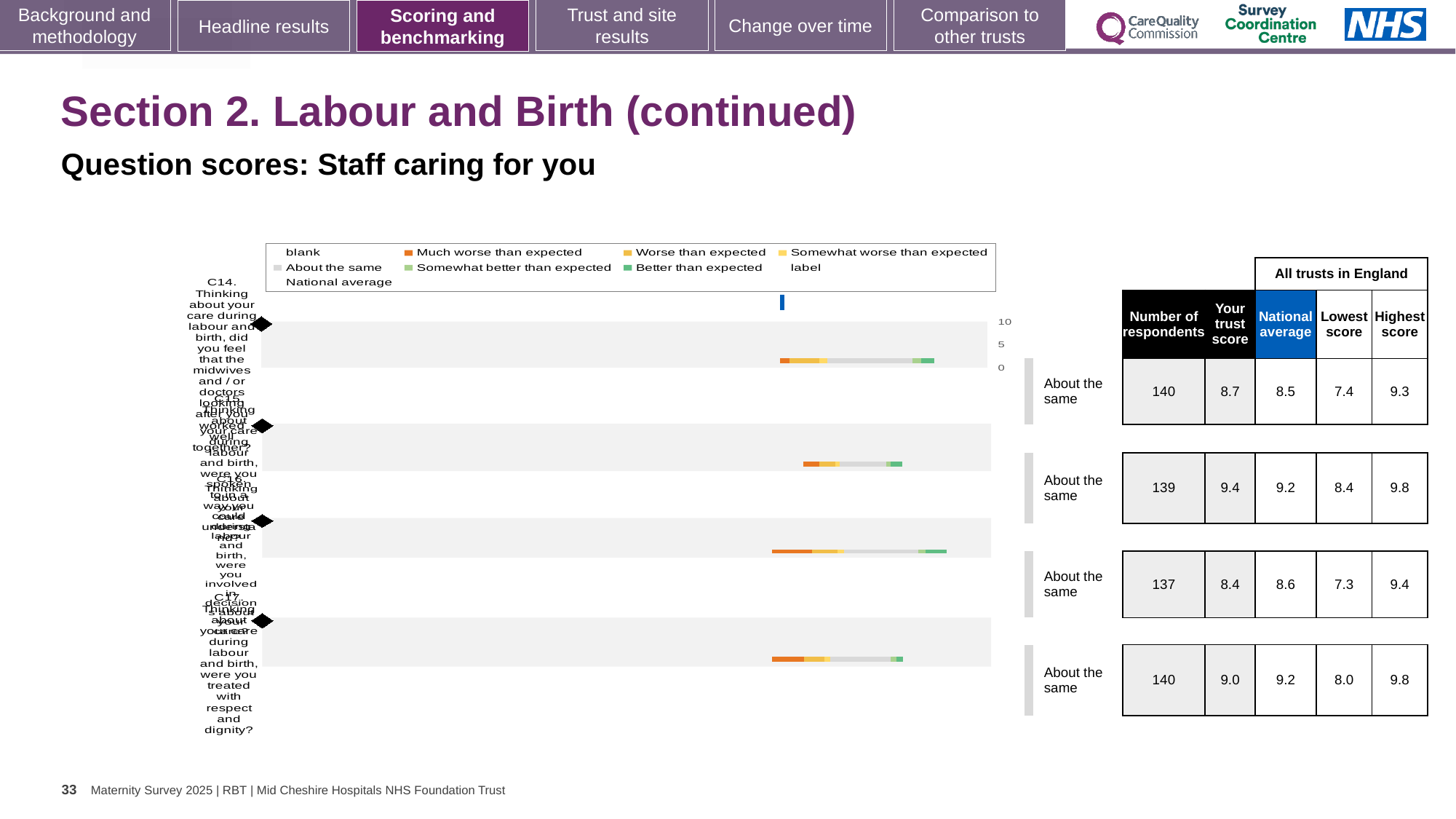
For the third row (C16), is the trust score or the national average larger? national average (8.6) What kind of chart is shown on the slide? bar chart What is the national average for the second row (C15) in the table beside the chart? 9.2 How many entries does the chart legend list? 9 What is the highest score across all trusts in England for the fourth row (C17)? 9.8 What is the difference between the trust score and the national average for the first row (C14)? 0.2 What is the number of respondents for the third row (C16)? 137 Which row has the lowest 'Your trust score' in the table? third row (C16), 8.4 What benchmark category label is shown next to each of the four bars? About the same Which row has the highest 'Your trust score' in the table? second row (C15), 9.4 What is the 'Your trust score' for the first row (C14) in the table beside the chart? 8.7 How many question rows (bars) are plotted in the chart? 4